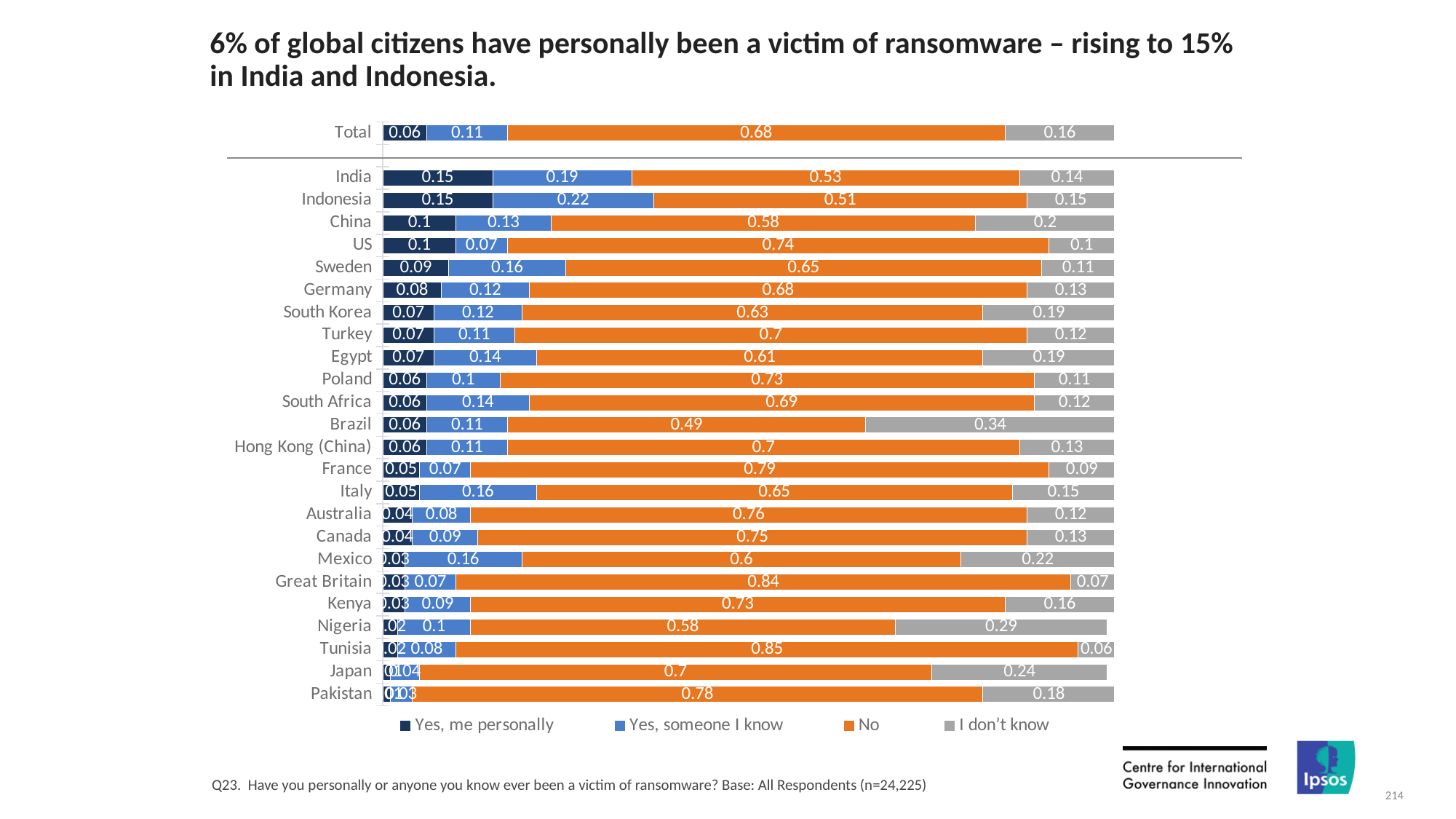
What is the 'Yes, someone I know' value for Indonesia? 0.22 What is the 'I don't know' value for Japan? 0.24 Which country has the lowest 'No' value? Brazil Which country has the highest 'I don't know' value? Brazil How many countries are listed below the Total bar? 24 Which is larger, the 'Yes, someone I know' value for India or for Indonesia? Indonesia What kind of chart is shown on the slide? Stacked bar chart What is the value for 'Yes, me personally' in the Total bar? 0.06 What is the difference between the 'No' value and the 'I don't know' value in the Total bar? 0.52 How many series does the legend list? 4 Which colour represents the 'No' series in the chart? Orange What is the 'No' value for Brazil? 0.49